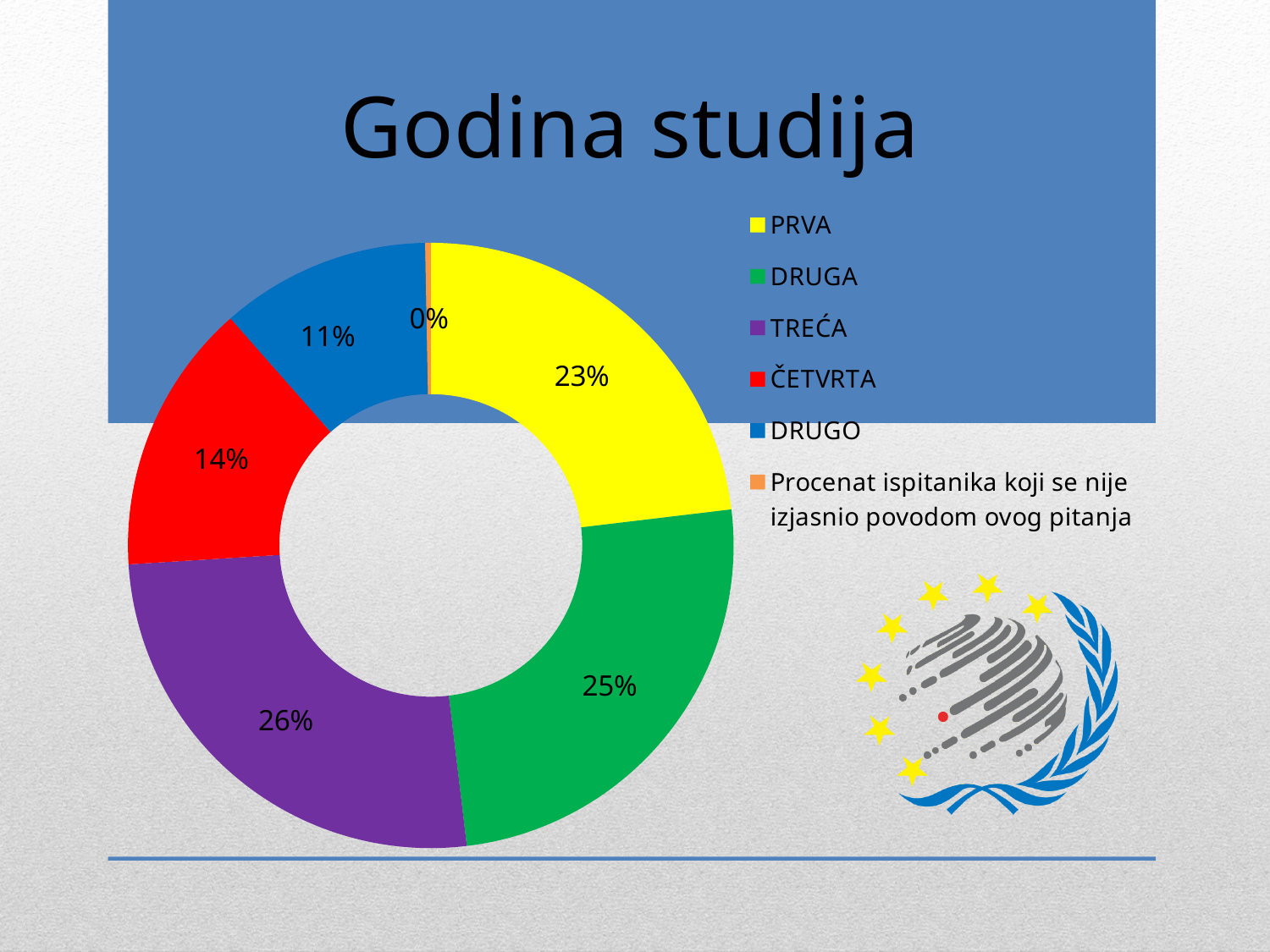
What kind of chart is shown on the slide? Doughnut (pie) chart What percentage is shown for PRVA? 23% Which category has the largest share of the chart? TREĆA What percentage is shown for DRUGO? 11% Which category has the smallest share of the chart? Procenat ispitanika koji se nije izjasnio povodom ovog pitanja How many categories does the legend list? 6 Which has the larger share, ČETVRTA or DRUGO? ČETVRTA What is the title of the chart? Godina studija What percentage is shown for ČETVRTA? 14% What is the difference between the shares of PRVA and DRUGO? 12% What percentage is shown for DRUGA? 25% What percentage is shown for TREĆA? 26%